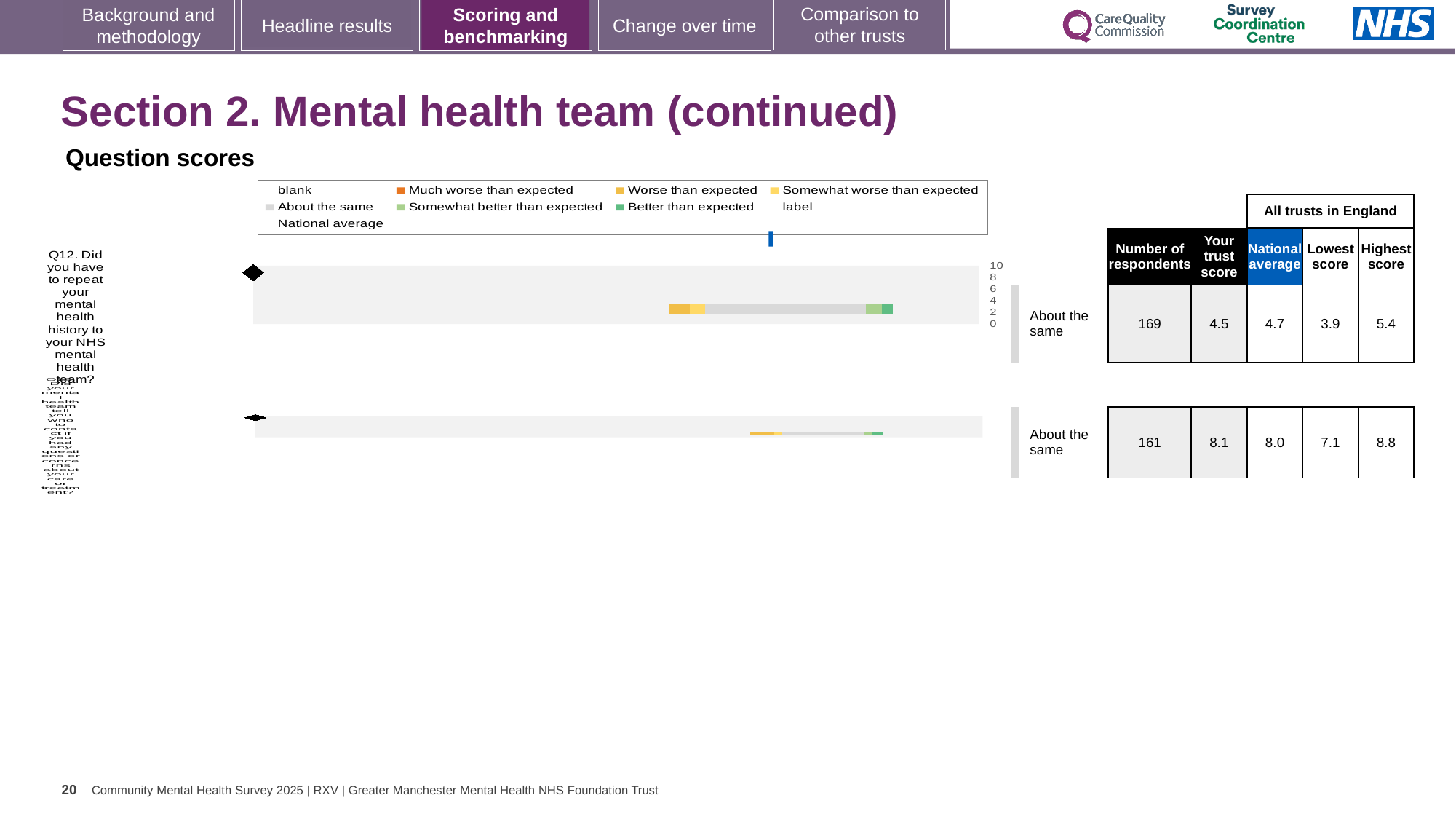
What kind of chart is used to show the question scores? Bar chart What is the lowest score among all trusts in England for Q12? 3.9 What is the trust score for Q12 (Did you have to repeat your mental health history to your NHS mental health team?)? 4.5 What benchmark category is shown for Q12? About the same For Q12, which is larger: the trust score or the national average? National average What is the trust score shown for the second (lower) question row on the chart? 8.1 How many respondents answered Q12? 169 What is the difference between the highest and lowest trust scores for Q12? 1.5 What colour represents 'Much worse than expected' in the legend? Orange What is the national average score for Q12? 4.7 How many question rows are plotted on the chart? 2 What is the highest score among all trusts in England for Q12? 5.4